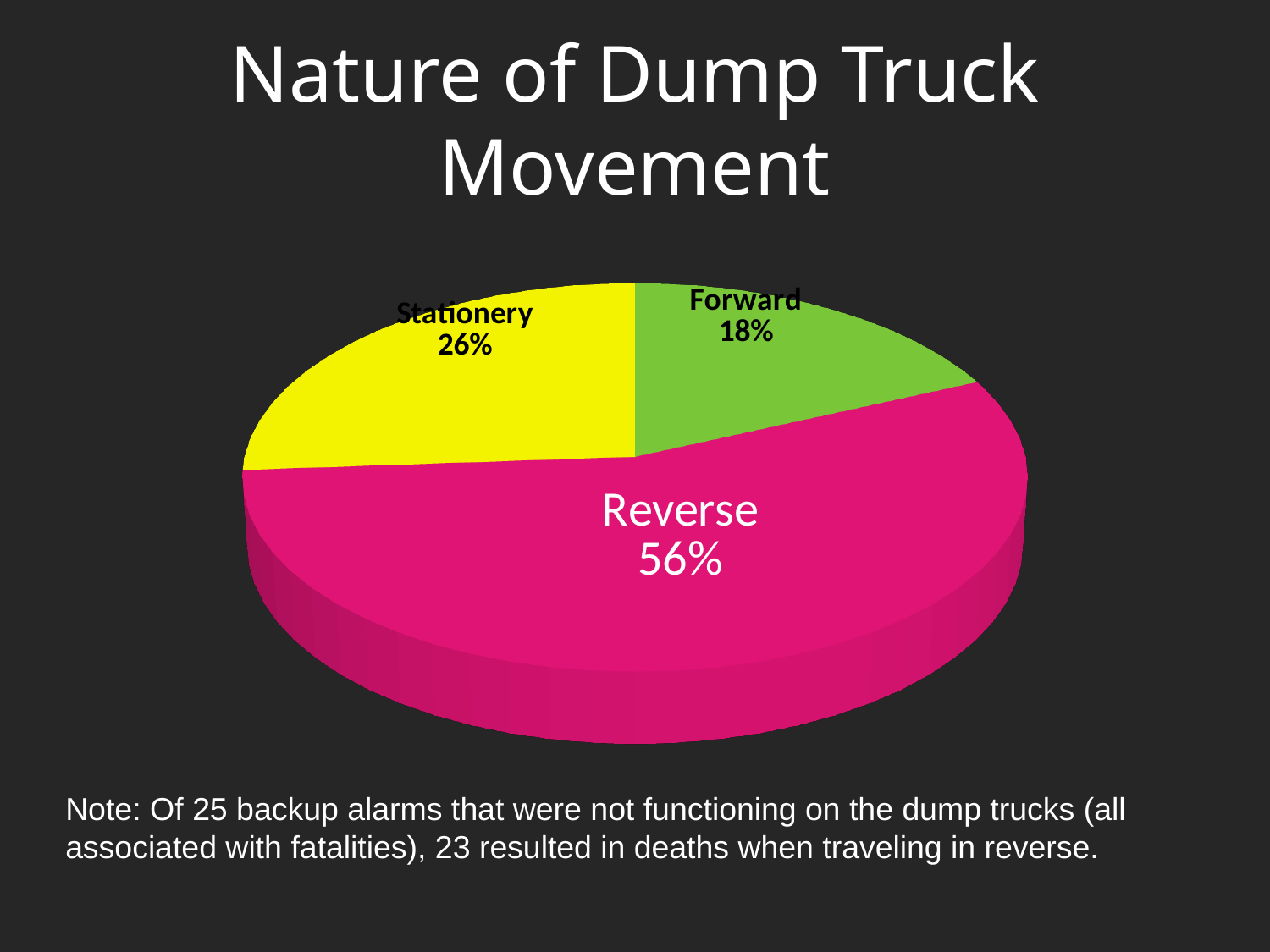
How many categories are shown in the pie chart? 3 What share of the pie does Forward represent? 18% What share of the pie does Reverse represent? 56% What colour is the Reverse slice? Pink Which category has the smallest slice of the pie? Forward What share of the pie does Stationery represent? 26% Which category has the largest slice of the pie? Reverse Which is larger, the Stationery slice or the Forward slice? Stationery What kind of chart is shown on the slide? Pie chart What is the title of the chart? Nature of Dump Truck Movement What is the difference in percentage points between Reverse and Stationery? 30 What is the difference in percentage points between Stationery and Forward? 8